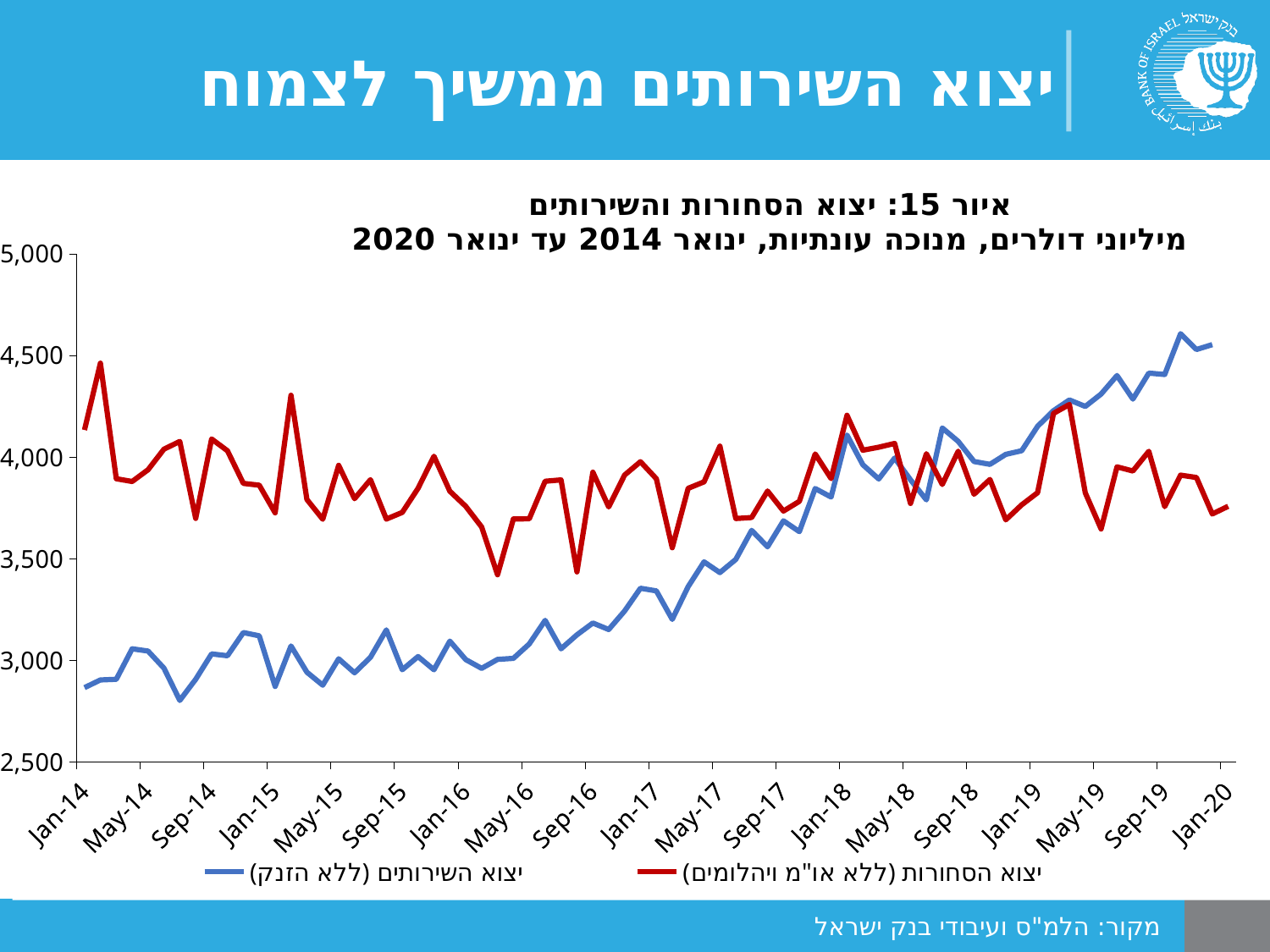
At Jan-14, which series has the higher value: יצוא השירותים (ללא הזנק) or יצוא הסחורות (ללא או"מ ויהלומים)? יצוא הסחורות (ללא או"מ ויהלומים) What is the highest value shown on the vertical axis? 5,000 Which colour is used for the series יצוא השירותים (ללא הזנק)? blue Is the value of יצוא הסחורות (ללא או"מ ויהלומים) at Jan-20 greater or less than 4,000? less What kind of chart is shown on the slide? line chart Does the series יצוא השירותים (ללא הזנק) rise or fall from Jan-14 to Jan-20? rise What is the title of the chart (first line)? איור 15: יצוא הסחורות והשירותים Is the value of יצוא השירותים (ללא הזנק) at Jan-14 greater or less than 3,000? less Is the value of יצוא השירותים (ללא הזנק) at Jan-17 greater or less than 3,500? less How many series does the legend list? 2